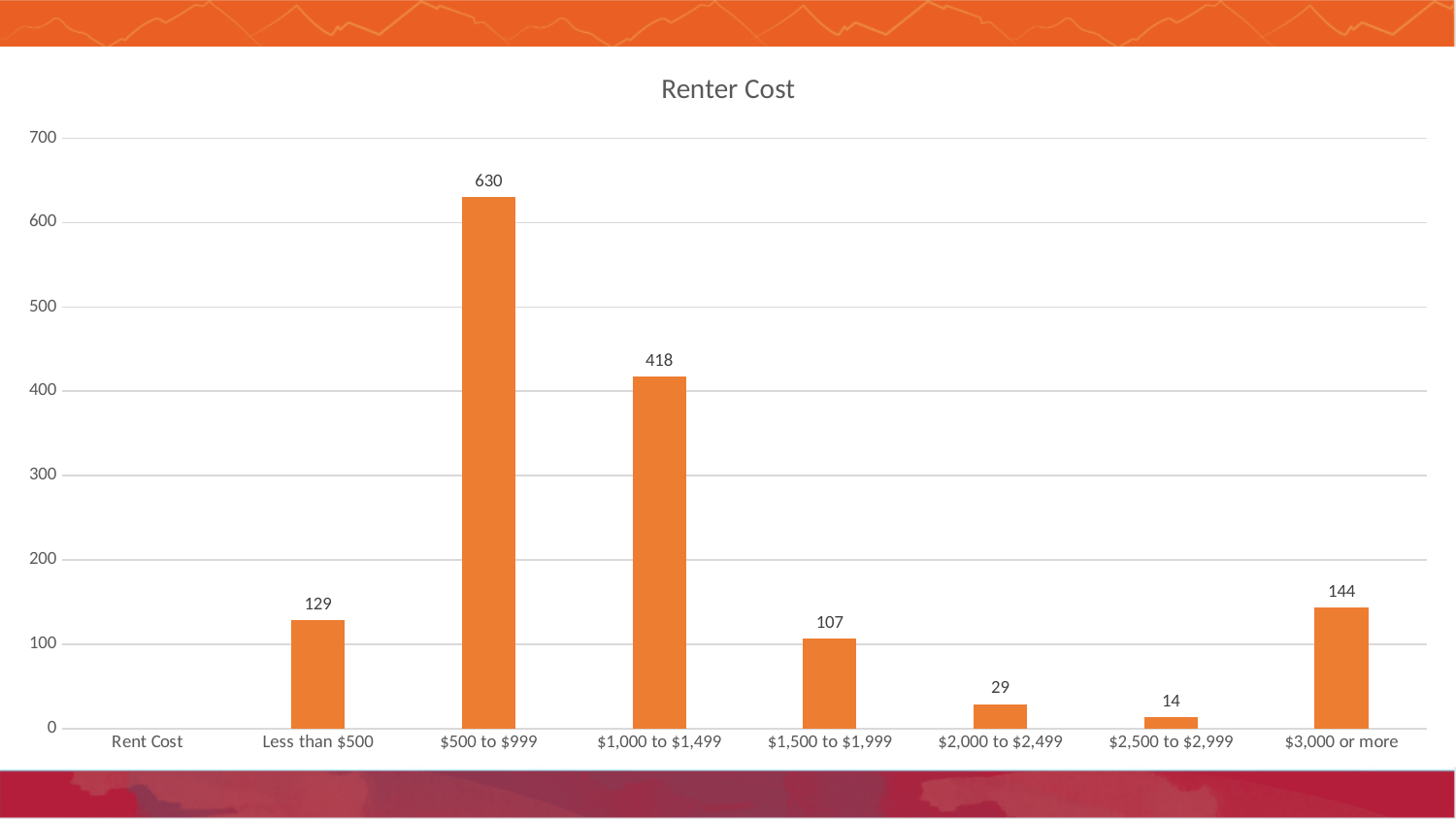
How many bars are plotted in the chart? 7 What is the value for the $500 to $999 category? 630 What kind of chart is shown on the slide? bar chart What is the value for the $2,000 to $2,499 category? 29 What is the difference between the values for $500 to $999 and $1,000 to $1,499? 212 What is the title of the chart? Renter Cost What is the value for the $3,000 or more category? 144 Is the value for $1,000 to $1,499 greater or less than 400? greater Which is larger, the value for Less than $500 or the value for $3,000 or more? $3,000 or more Which category has the lowest plotted value? $2,500 to $2,999 Which category has the highest value? $500 to $999 What is the difference between the values for $3,000 or more and Less than $500? 15